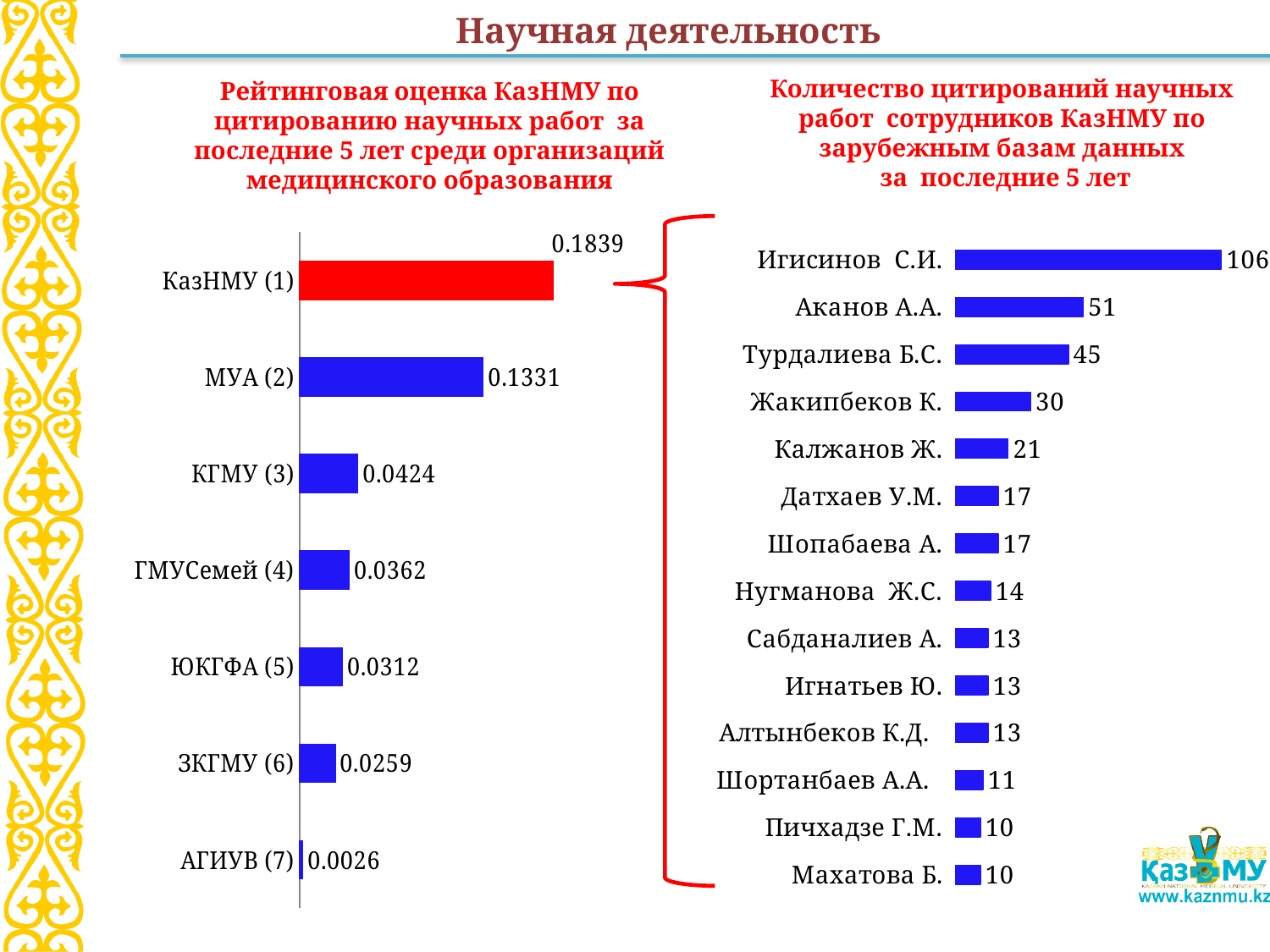
In the right chart (Количество цитирований научных работ сотрудников КазНМУ), how many citations does Жакипбеков К. have? 30 In the left chart (Рейтинговая оценка КазНМУ по цитированию научных работ), which bar is coloured red rather than blue? КазНМУ (1) In the left chart (Рейтинговая оценка КазНМУ по цитированию научных работ), what is the value for КГМУ (3)? 0.0424 In the right chart (Количество цитирований научных работ сотрудников КазНМУ), how many citations does Игисинов С.И. have? 106 In the right chart (Количество цитирований научных работ сотрудников КазНМУ), how many employees are listed? 14 In the left chart (Рейтинговая оценка КазНМУ по цитированию научных работ), what is the value for КазНМУ (1)? 0.1839 In the left chart (Рейтинговая оценка КазНМУ по цитированию научных работ), how many organisations are shown? 7 In the right chart (Количество цитирований научных работ сотрудников КазНМУ), who has the most citations? Игисинов С.И. In the right chart (Количество цитирований научных работ сотрудников КазНМУ), what is the difference in citations between Аканов А.А. and Турдалиева Б.С.? 6 In the right chart (Количество цитирований научных работ сотрудников КазНМУ), who has more citations, Калжанов Ж. or Нугманова Ж.С.? Калжанов Ж. In the left chart (Рейтинговая оценка КазНМУ по цитированию научных работ), what is the difference between the values for КазНМУ (1) and МУА (2)? 0.0508 In the left chart (Рейтинговая оценка КазНМУ по цитированию научных работ), which category has the lowest value? АГИУВ (7)